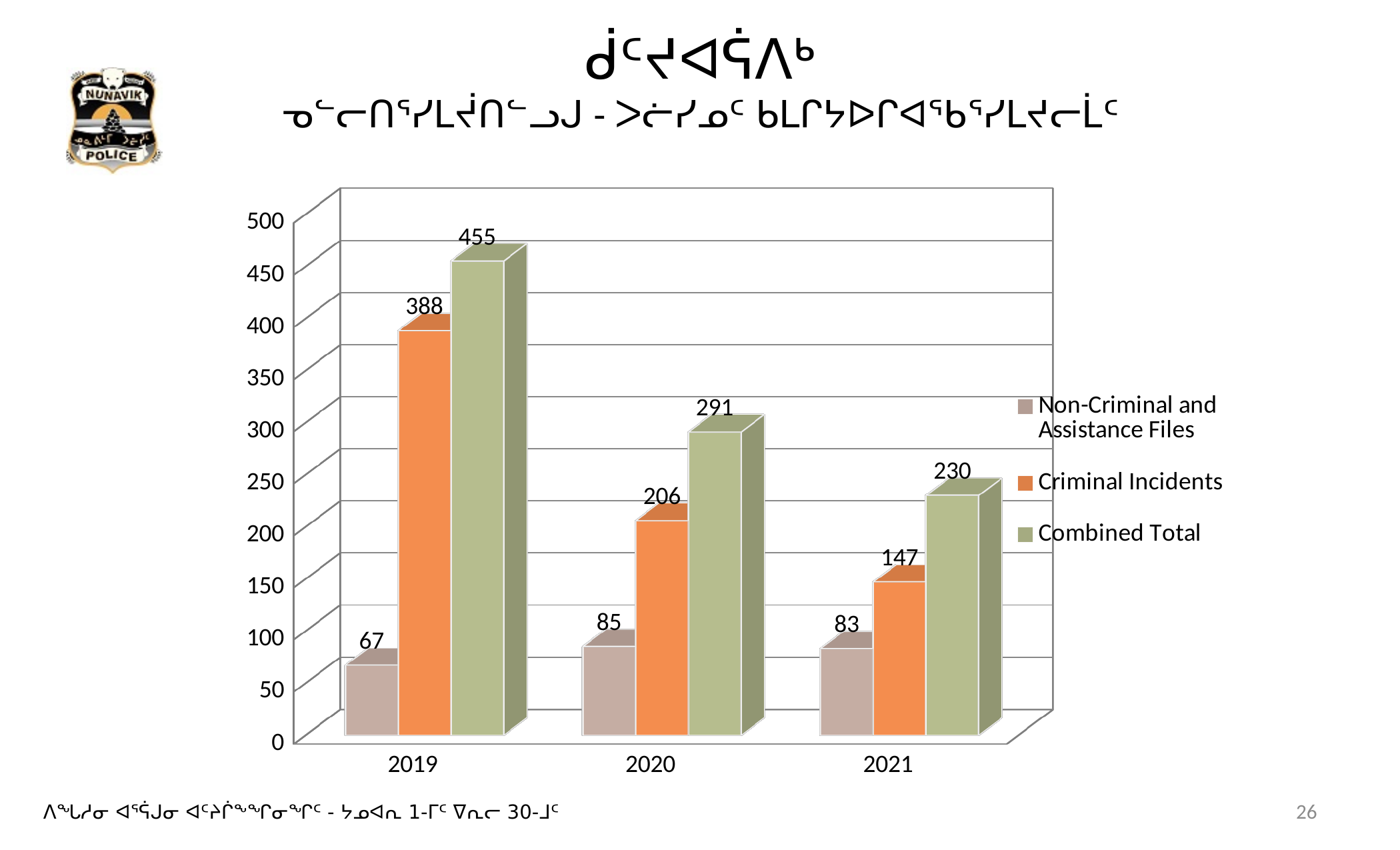
What kind of chart is shown on the slide? Bar chart Do the Combined Total values rise or fall from 2019 to 2021? Fall What is the value for Non-Criminal and Assistance Files in 2020? 85 Which is larger: Criminal Incidents in 2021 or Non-Criminal and Assistance Files in 2021? Criminal Incidents in 2021 Which year has the lowest value for Non-Criminal and Assistance Files? 2019 Which year has the highest Combined Total? 2019 What is the difference between Criminal Incidents in 2019 and 2020? 182 What is the value for Criminal Incidents in 2019? 388 What is the Combined Total for 2021? 230 How many years are shown on the x axis? 3 How many series does the legend list? 3 Which series is shown in orange in the legend? Criminal Incidents